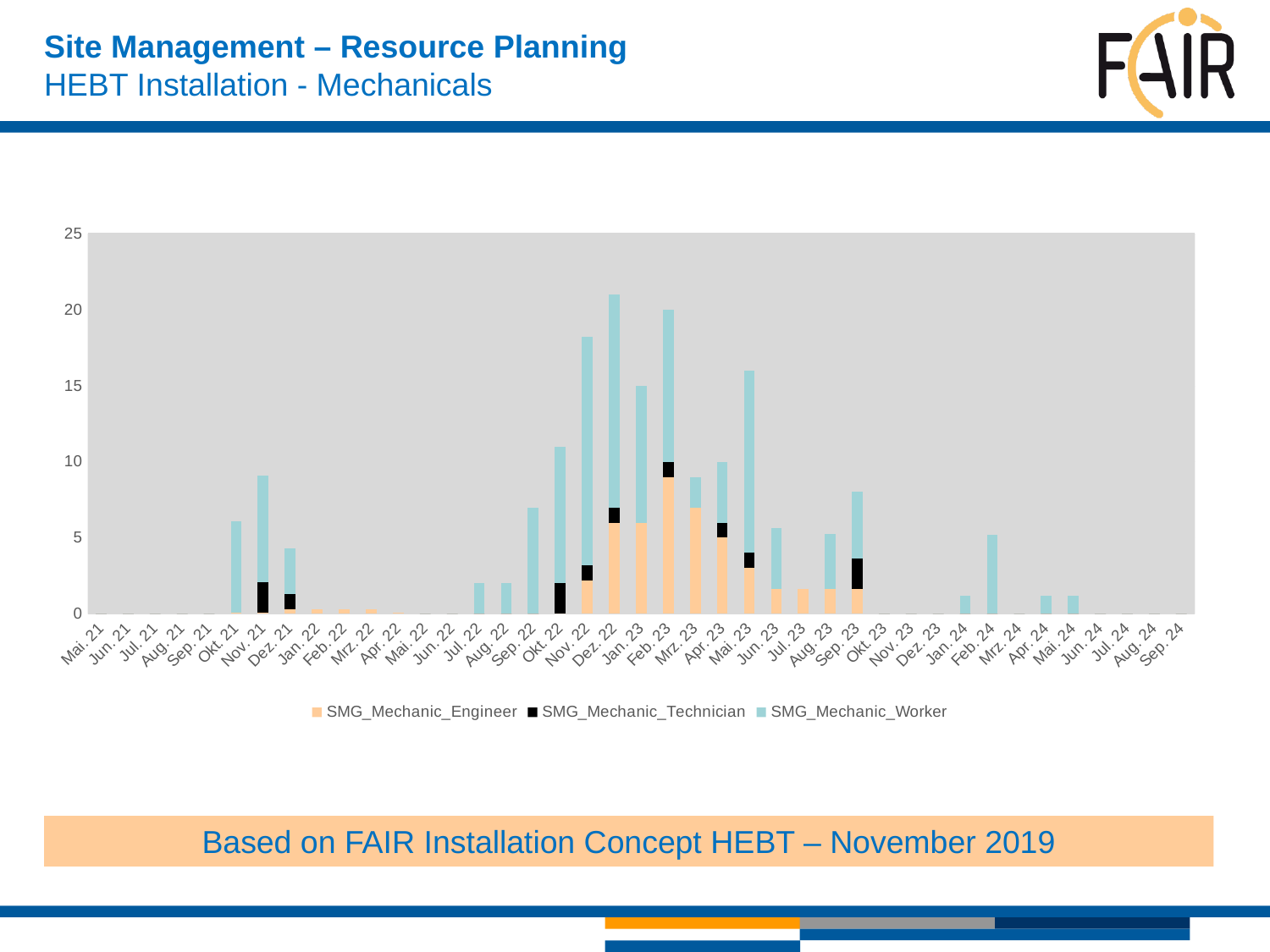
Is the total value for Mrz. 23 greater or less than 10? less Which month has the taller stacked bar, Dez. 22 or Jan. 23? Dez. 22 How many months (categories) are shown along the x axis? 41 How many series does the chart legend list? 3 Do the stacked bar totals rise or fall from Sep. 22 to Dez. 22? rise Is the total value for Nov. 22 greater or less than 15? greater Is the total value for Okt. 22 greater or less than 10? greater Which series is shown in black in the legend? SMG_Mechanic_Technician What kind of chart is shown on the slide? Stacked bar chart Which month has the taller stacked bar, Okt. 21 or Nov. 21? Nov. 21